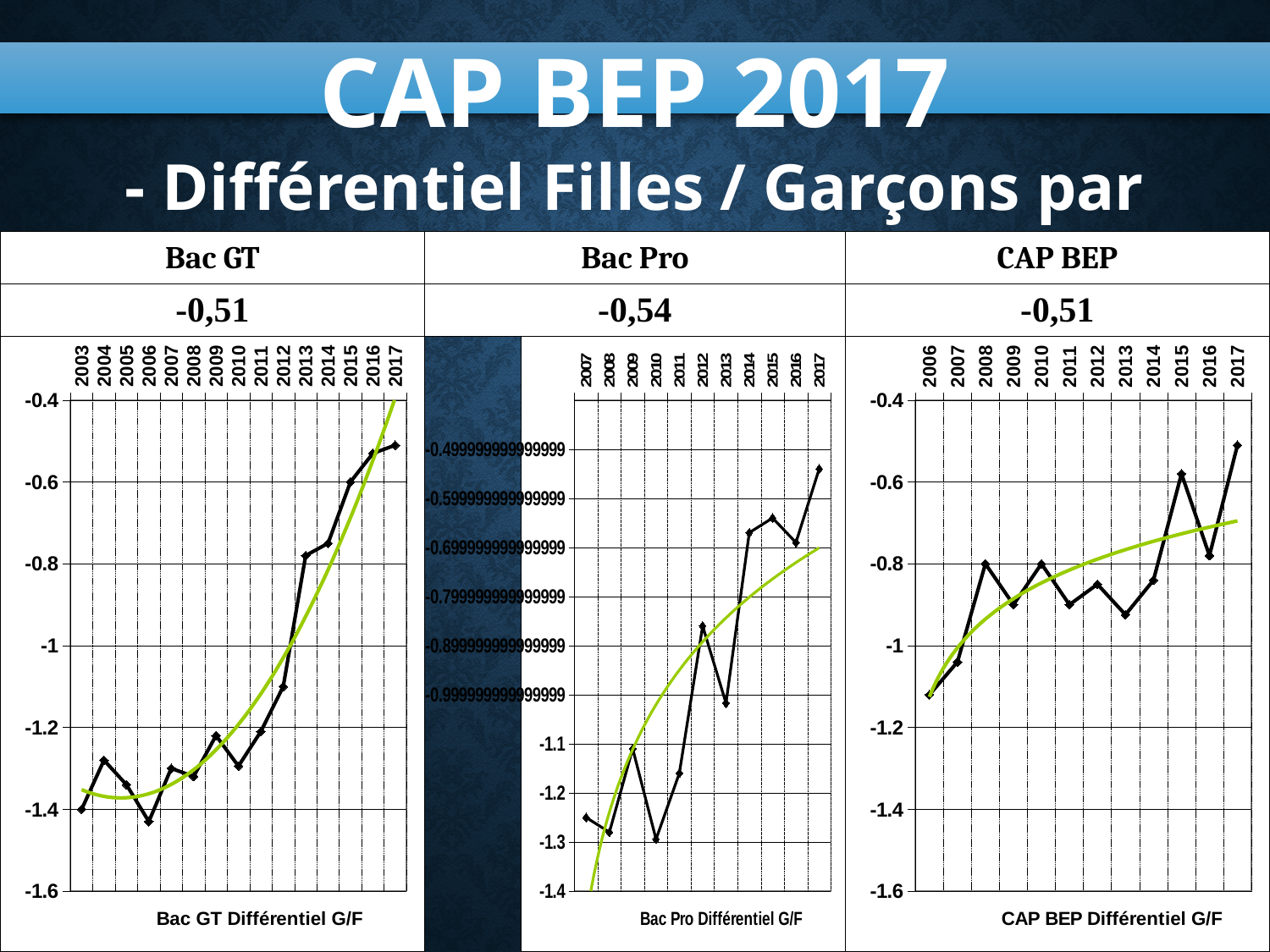
On the Bac GT Différentiel G/F chart, which year has the lowest value? 2006 How many years are plotted on the CAP BEP Différentiel G/F chart? 12 What kind of chart is the Bac GT Différentiel G/F chart? line chart On the Bac GT Différentiel G/F chart, is the value for 2012 greater or less than -1? less On the Bac GT Différentiel G/F chart, which year has the highest value? 2017 On the Bac Pro Différentiel G/F chart, which year has the lowest value? 2010 On the CAP BEP Différentiel G/F chart, which is larger, the value for 2015 or the value for 2016? 2015 On the CAP BEP Différentiel G/F chart, is the value for 2006 greater or less than -1? less How many years are plotted on the Bac Pro Différentiel G/F chart? 11 On the Bac Pro Différentiel G/F chart, is the value for 2010 greater or less than -1.2? less On the Bac GT Différentiel G/F chart, do the values generally rise or fall from 2003 to 2017? rise How many years are plotted on the Bac GT Différentiel G/F chart? 15